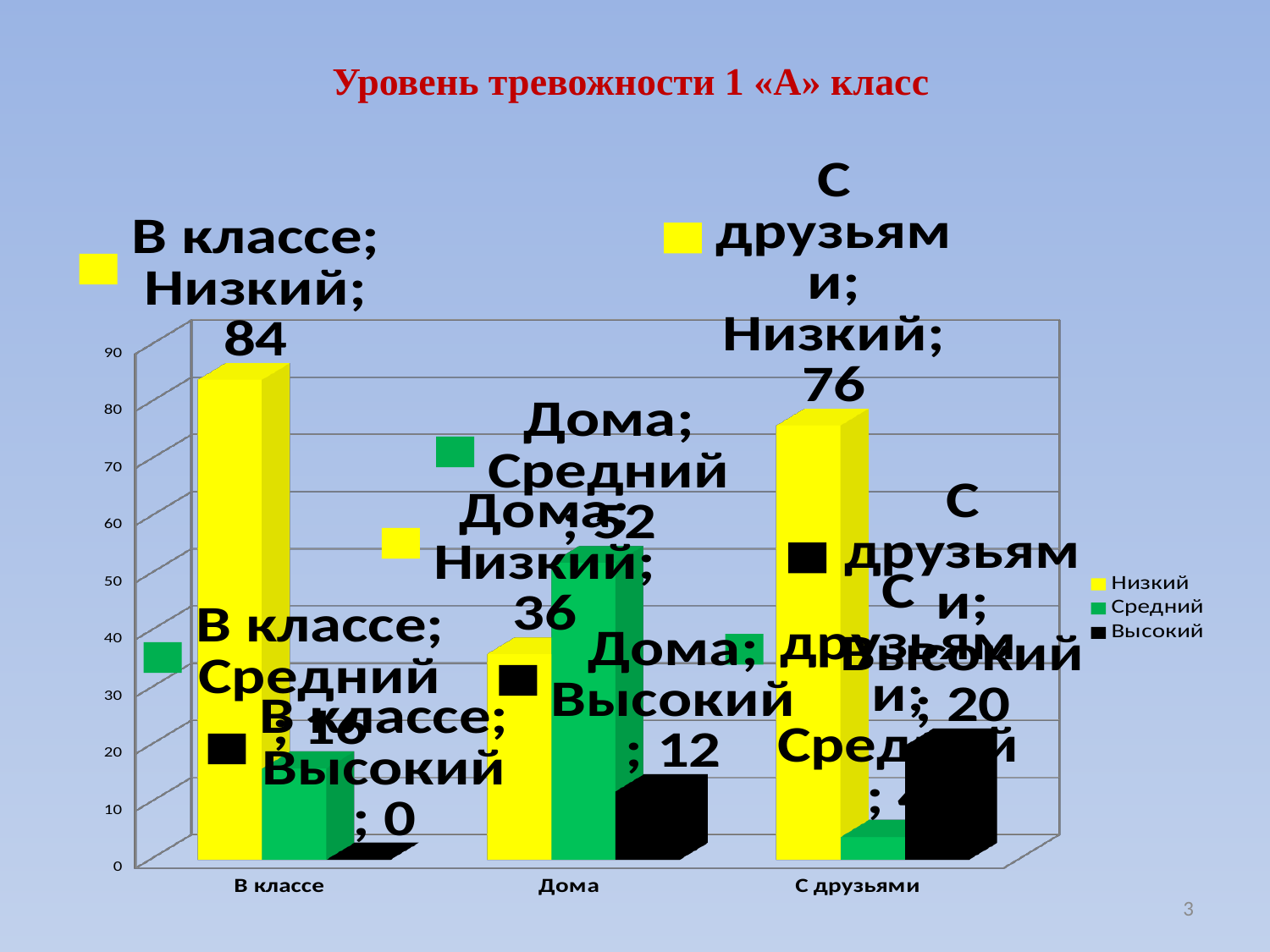
Which category has the lowest value for the Низкий series? Дома What is the difference between the Низкий values for В классе and С друзьями? 8 How many series does the legend list? 3 What is the value for Низкий in the Дома category? 36 What is the value for Высокий in the В классе category? 0 Which is larger in the Дома category: Низкий or Средний? Средний What is the value for Средний in the Дома category? 52 How many categories are shown on the x axis? 3 Which category has the highest value for the Низкий series? В классе What type of chart is shown on the slide? Bar chart What is the value for Высокий in the С друзьями category? 20 What is the value for Низкий in the В классе category? 84